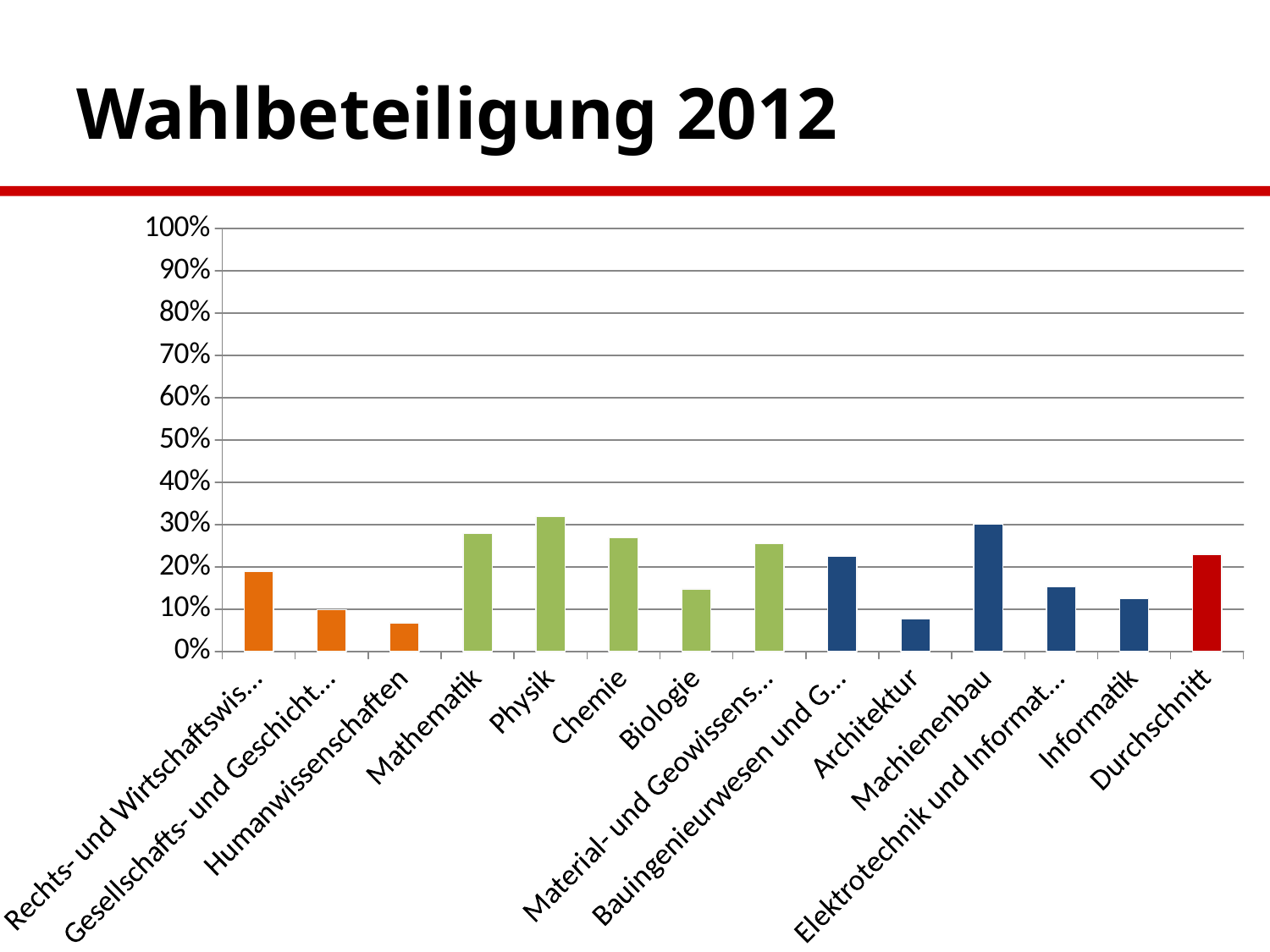
How many categories are shown on the x axis of the chart? 14 What is the title of the slide? Wahlbeteiligung 2012 Which is larger, the value for Mathematik or the value for Biologie? Mathematik Is the value for Durchschnitt greater or less than 20%? greater Is the value for Biologie greater or less than 20%? less Which is larger, the value for Chemie or the value for Architektur? Chemie Is the value for Physik greater or less than 30%? greater What kind of chart is shown on the slide? bar chart What colour is the bar for Durchschnitt? red Which category has the highest value in the chart? Physik